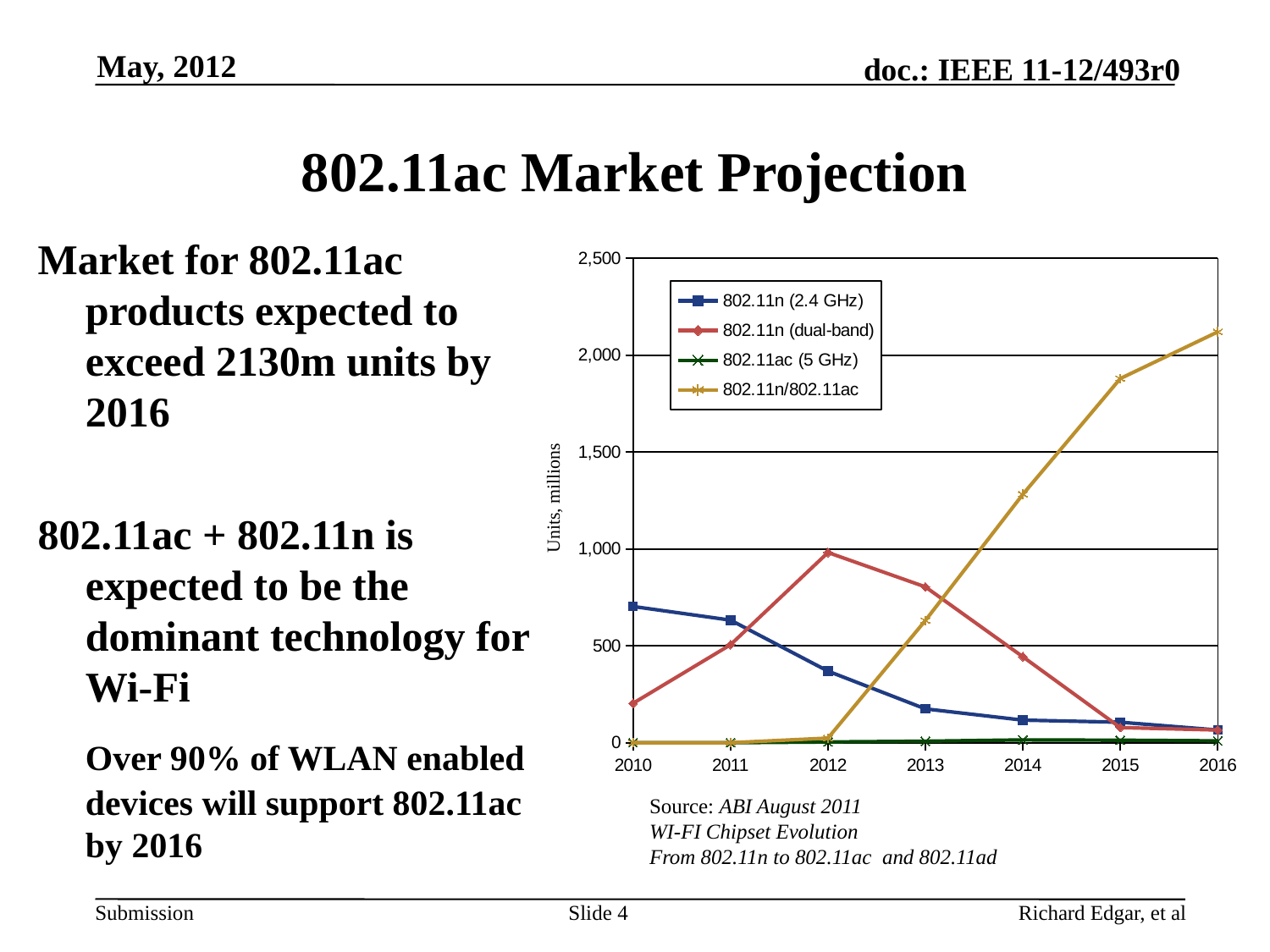
What kind of chart is shown on the slide? line chart In which year does the 802.11n (dual-band) series reach its peak? 2012 Is the value for 802.11n (2.4 GHz) in 2010 greater or less than 500? greater In 2014, which series has the higher value: 802.11n/802.11ac or 802.11n (dual-band)? 802.11n/802.11ac Is the value for 802.11n/802.11ac in 2016 greater or less than 2,000? greater Is the value for 802.11n/802.11ac in 2014 greater or less than 1,000? greater How many years are plotted along the x axis of the chart? 7 Which series has the highest value in 2016? 802.11n/802.11ac Does the 802.11n (2.4 GHz) series rise or fall from 2010 to 2016? fall How many series does the chart legend list? 4 What is the label on the y axis of the chart? Units, millions